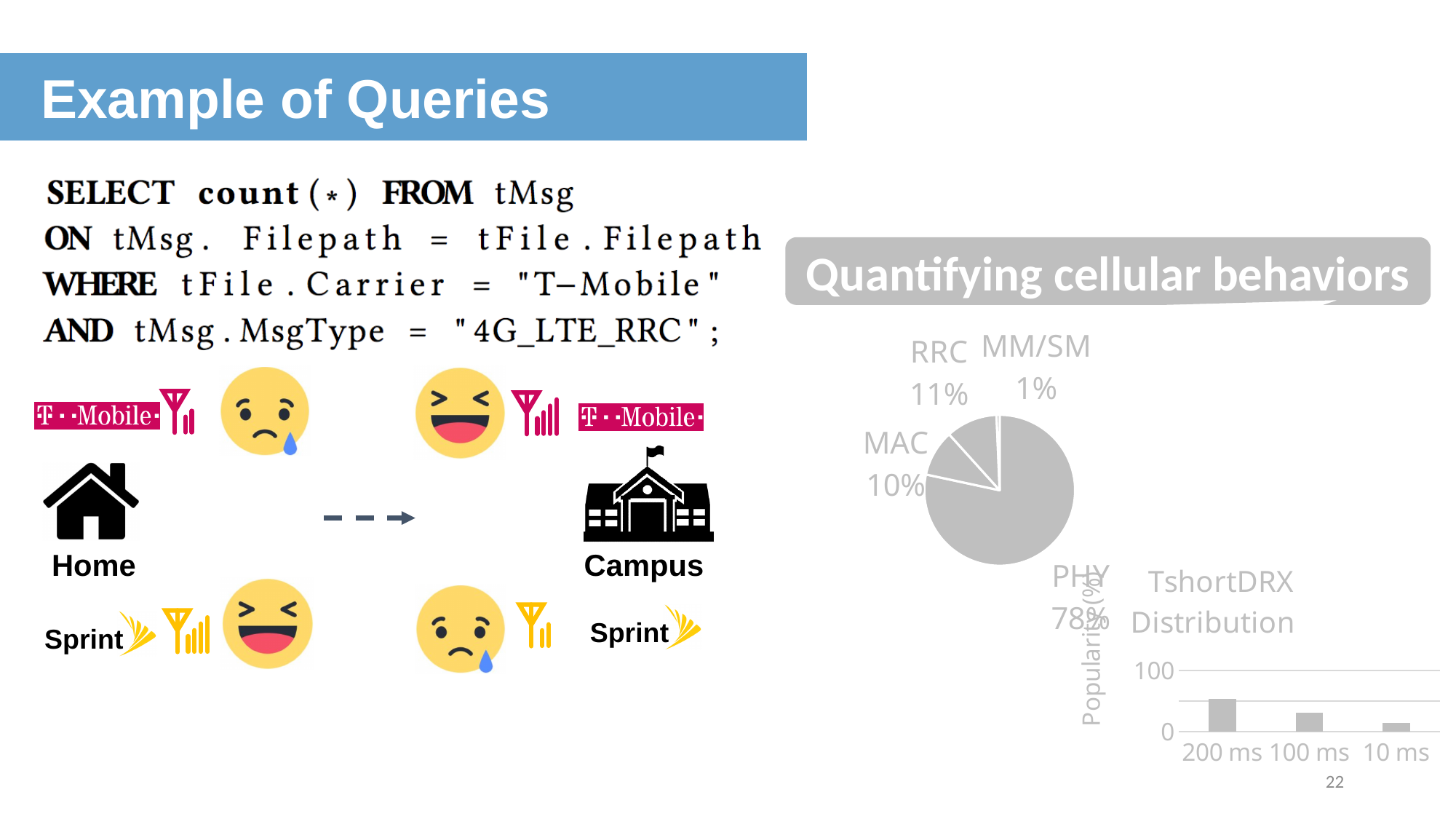
In the TshortDRX Distribution chart, what kind of chart is shown? bar chart In the pie chart, what share does MM/SM have? 1% In the pie chart, which category has the largest slice? PHY In the pie chart, what is the difference in percentage points between PHY and RRC? 67 In the TshortDRX Distribution chart, is the value for 200 ms greater or less than 100? less In the pie chart, which category has the smallest slice? MM/SM In the TshortDRX Distribution chart, which category has the tallest bar? 200 ms In the pie chart, how many slices are there? 4 In the pie chart, what share does PHY have? 78% In the pie chart, what share does MAC have? 10% In the pie chart, what share does RRC have? 11% In the TshortDRX Distribution chart, how many categories are on the x axis? 3